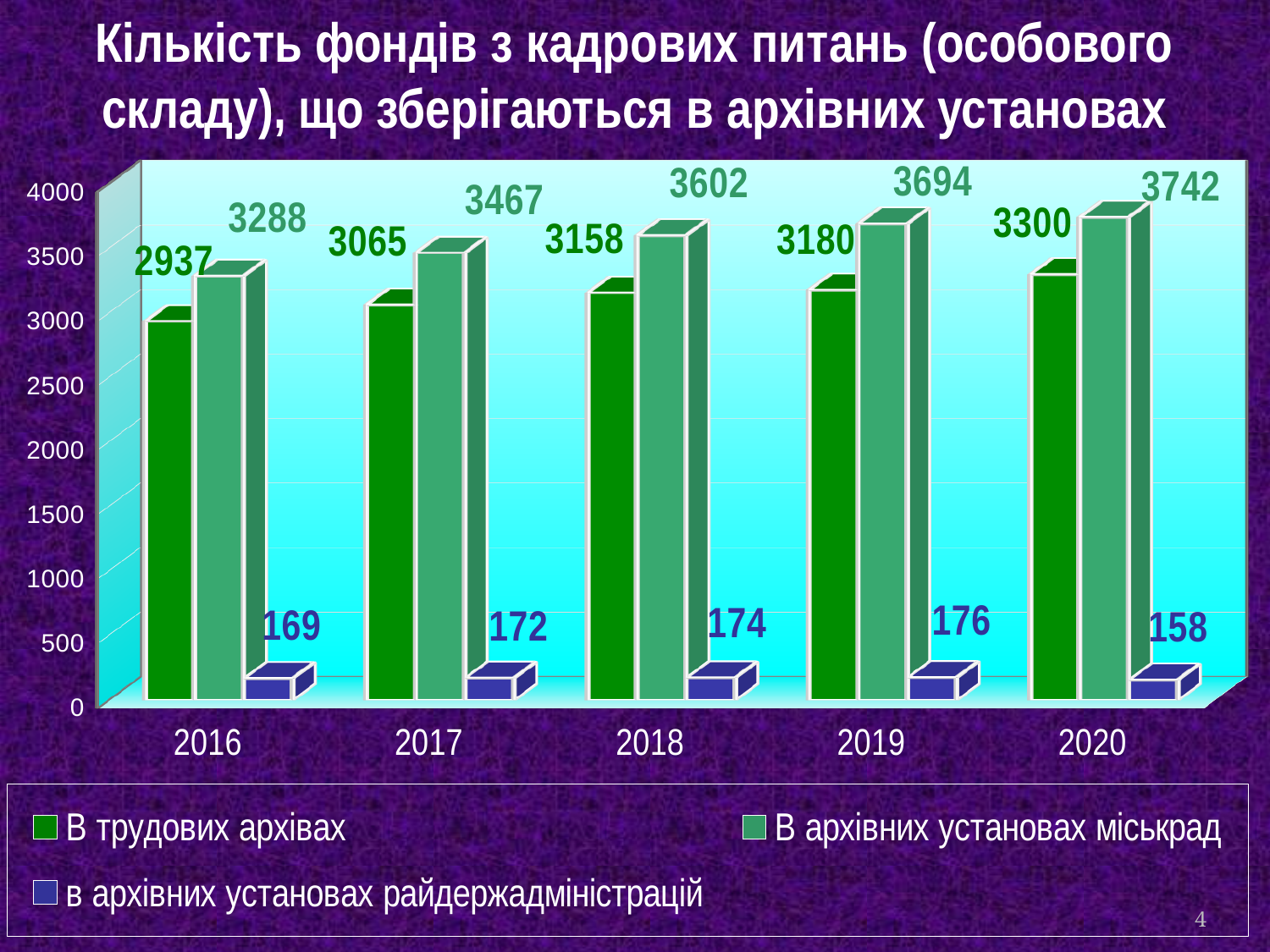
In which year is the value for "в архівних установах райдержадміністрацій" lowest? 2020 What is the difference between the "В архівних установах міськрад" value and the "В трудових архівах" value in 2019? 514 What is the value for "в архівних установах райдержадміністрацій" in 2018? 174 What is the value for "В архівних установах міськрад" in 2020? 3742 What is the value for "В трудових архівах" in 2016? 2937 Do the values for "В трудових архівах" rise or fall from 2016 to 2020? rise Is the value for "В трудових архівах" in 2020 greater or less than 3000? greater Which is larger in 2017: the value for "В трудових архівах" or the value for "В архівних установах міськрад"? В архівних установах міськрад How many years are shown on the x axis? 5 What kind of chart is shown on the slide? bar chart How many series does the legend list? 3 In which year is the value for "В архівних установах міськрад" highest? 2020